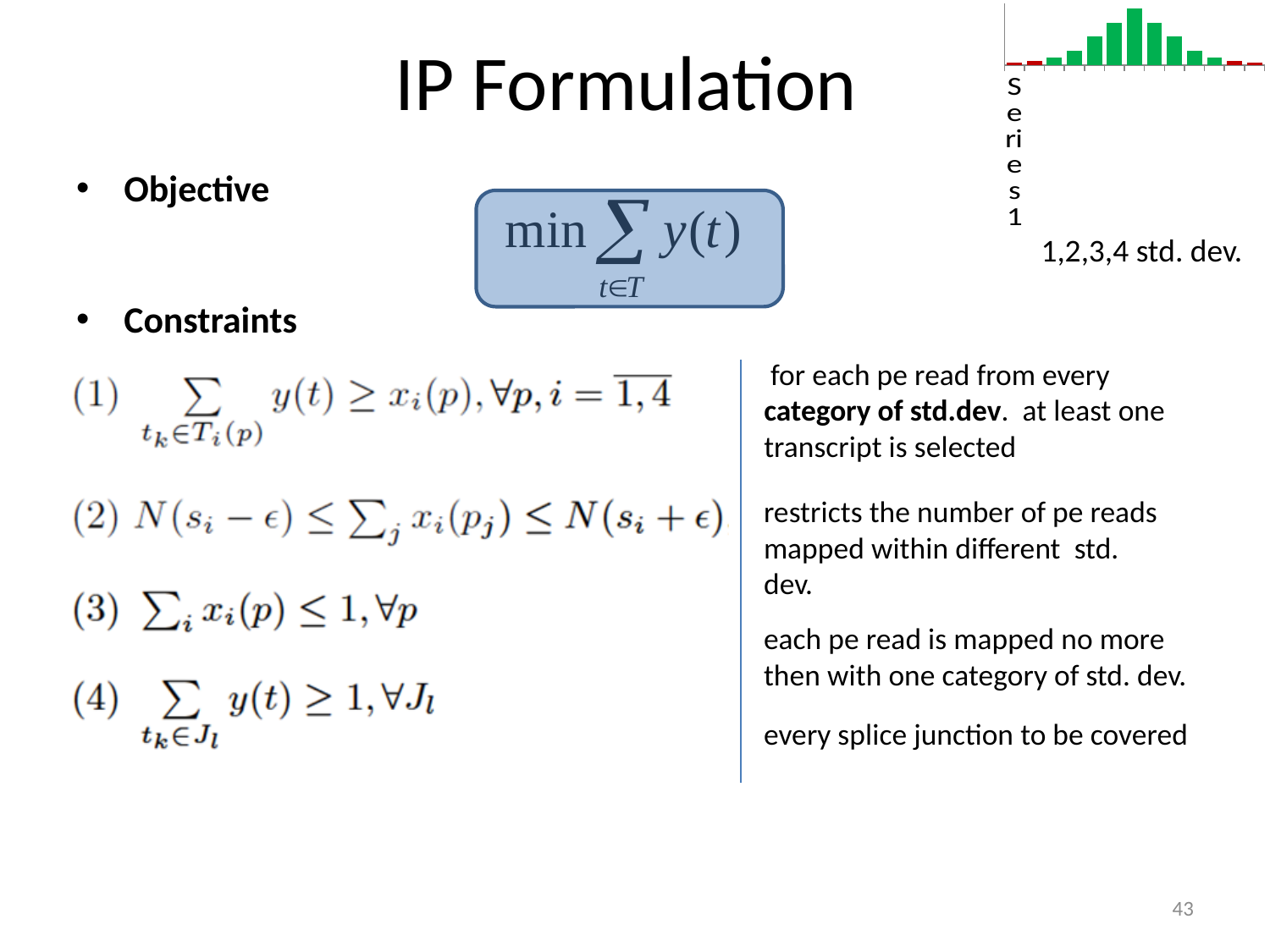
In the chart in the top right corner, do the bar heights rise or fall moving from the left edge toward the middle? rise What colour are the bars in the chart in the top right corner? green In the chart in the top right corner, do the bar heights rise or fall moving from the middle toward the right edge? fall What is the name of the series listed in the legend of the chart in the top right corner? Series 1 How many series does the legend of the chart in the top right corner list? 1 What kind of chart is shown in the top right corner of the slide? bar chart